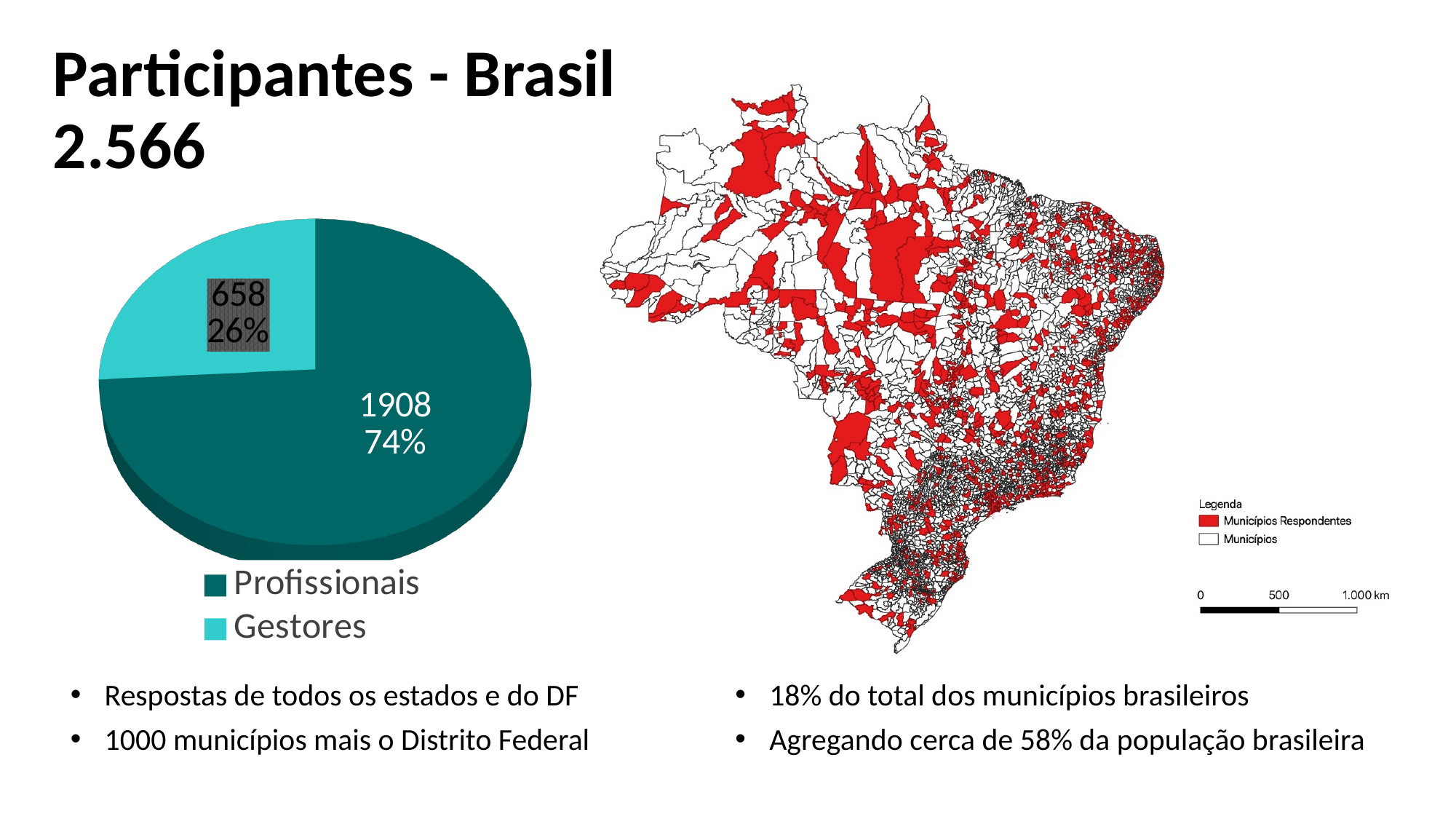
How many participants are Profissionais according to the pie chart? 1908 What percentage of the pie chart does the Profissionais slice represent? 74% What is the total of the two slices in the pie chart? 2566 What kind of chart is shown on the left of the slide? pie chart What percentage of the pie chart does the Gestores slice represent? 26% How many categories does the pie chart show? 2 Which category has the smallest slice in the pie chart? Gestores How many participants are Gestores according to the pie chart? 658 What is the difference between the number of Profissionais and Gestores in the pie chart? 1250 Which is larger in the pie chart, Profissionais or Gestores? Profissionais Which category has the largest slice in the pie chart? Profissionais What colour is the Gestores slice in the pie chart? light teal